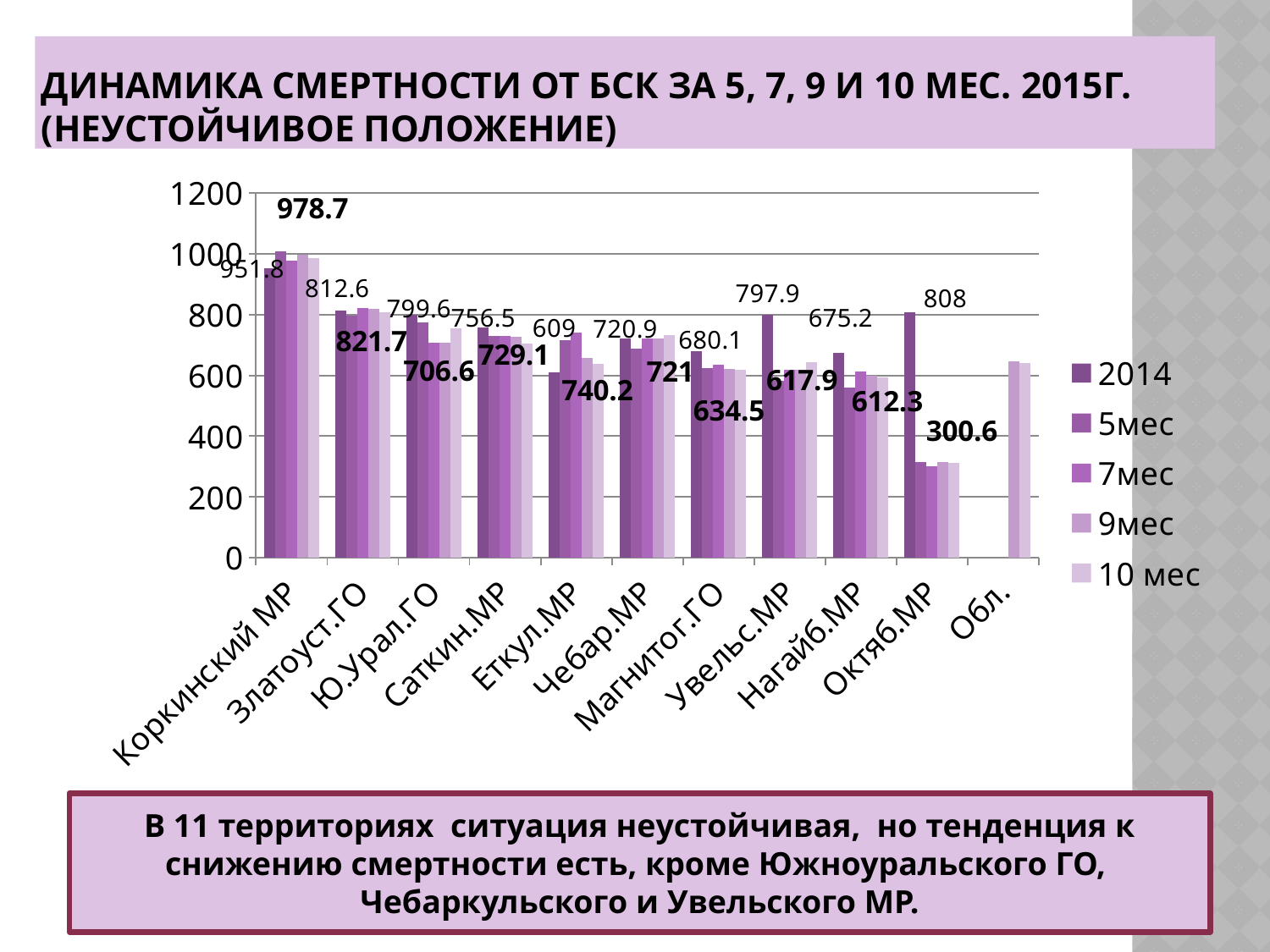
What is the difference between the 2014 values for Увельс.МР and Нагайб.МР? 122.7 What is the 2014 value for Коркинский МР? 951.8 Which category has the highest 2014 value? Коркинский МР Which category has the lowest labelled 2014 value? Еткул.МР What kind of chart is shown on the slide? bar chart What is the 2014 value for Октяб.МР? 808 How many series does the legend list? 5 How many categories are shown along the x axis? 11 What is the 2014 value for Еткул.МР? 609 Is the 10 мес value for Октяб.МР greater or less than 400? less Is the 10 мес value for Обл. greater or less than 600? greater Which has the larger 2014 value, Златоуст.ГО or Ю.Урал.ГО? Златоуст.ГО